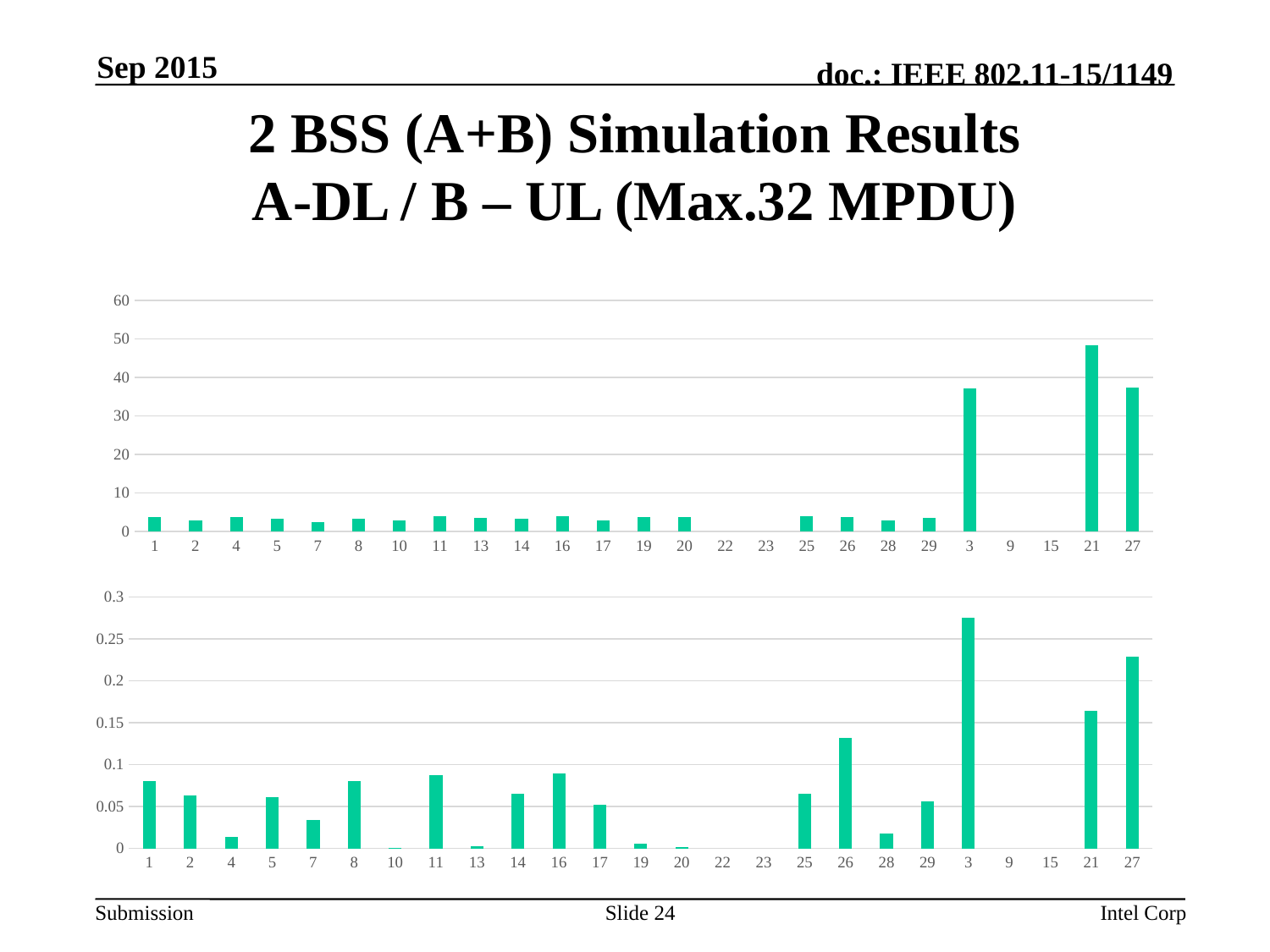
In the top chart, which is larger, the value for category 21 or the value for category 3? 21 What kind of chart is the top chart on the slide? bar chart How many category labels are shown on the x axis of the bottom chart? 25 In the bottom chart, which category has the highest value? 3 In the bottom chart, is the value for category 4 greater or less than 0.05? less In the top chart, is the value for category 1 greater or less than 10? less In the bottom chart, which is larger, the value for category 26 or the value for category 25? 26 In the top chart, which category has the highest value? 21 In the top chart, is the value for category 3 greater or less than 30? greater